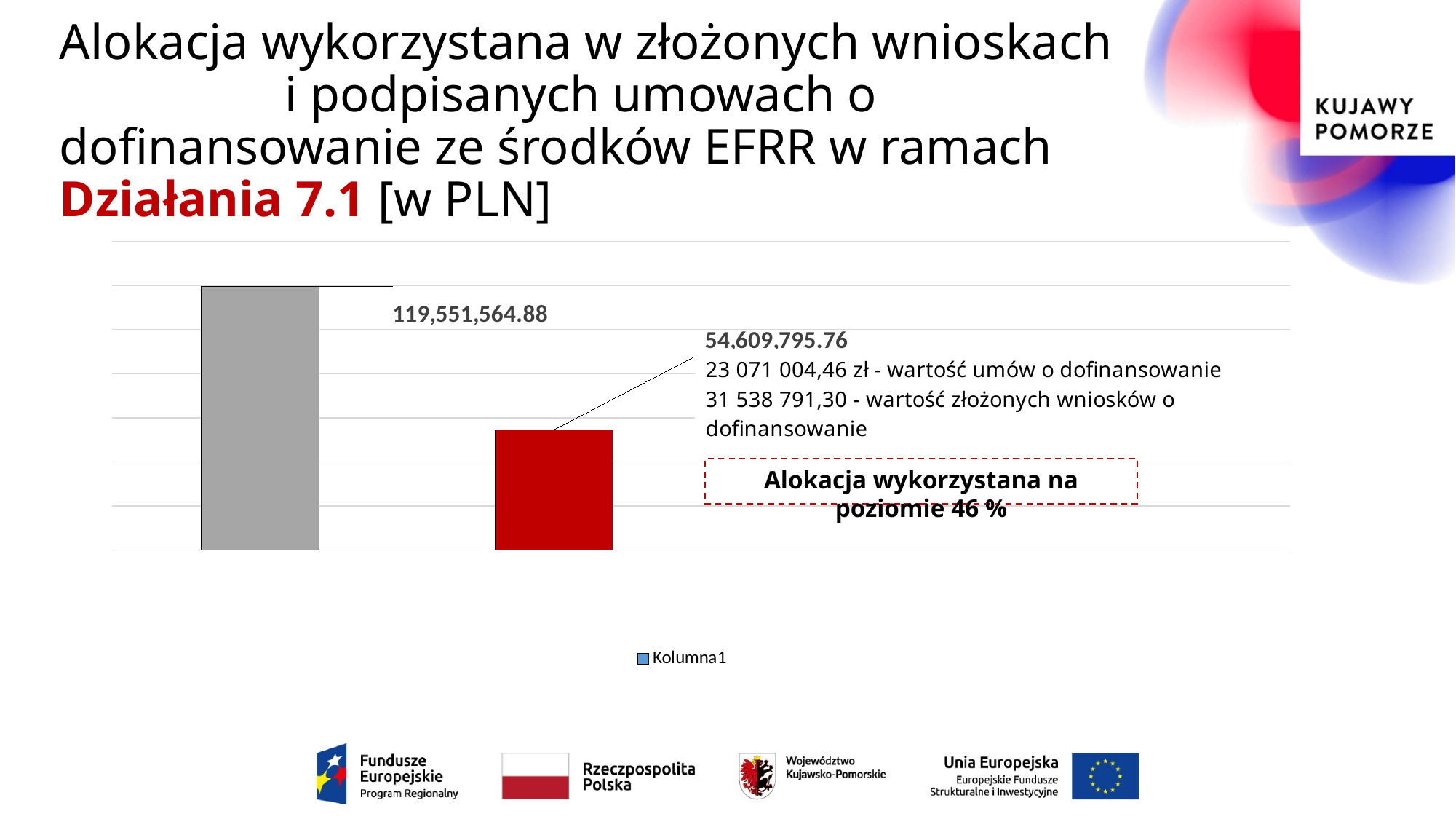
According to the annotation next to the red bar, what is the value of submitted applications (wartość złożonych wniosków o dofinansowanie)? 31 538 791,30 What value is labelled on the gray bar? 119,551,564.88 Which bar shows the lowest value in the chart? the red bar What is the name of the series shown in the chart legend? Kolumna1 What is the difference between the gray bar value and the red bar value? 64,941,769.12 According to the annotation next to the red bar, what is the value of signed co-financing agreements (wartość umów o dofinansowanie)? 23 071 004,46 zł How many bars are plotted in the chart? 2 Which bar has the higher value, the gray bar or the red bar? the gray bar What percentage of the allocation is stated as used in the boxed text on the chart? 46 % What type of chart is shown on the slide? bar chart How many series does the chart legend list? 1 What value is labelled on the red bar? 54,609,795.76